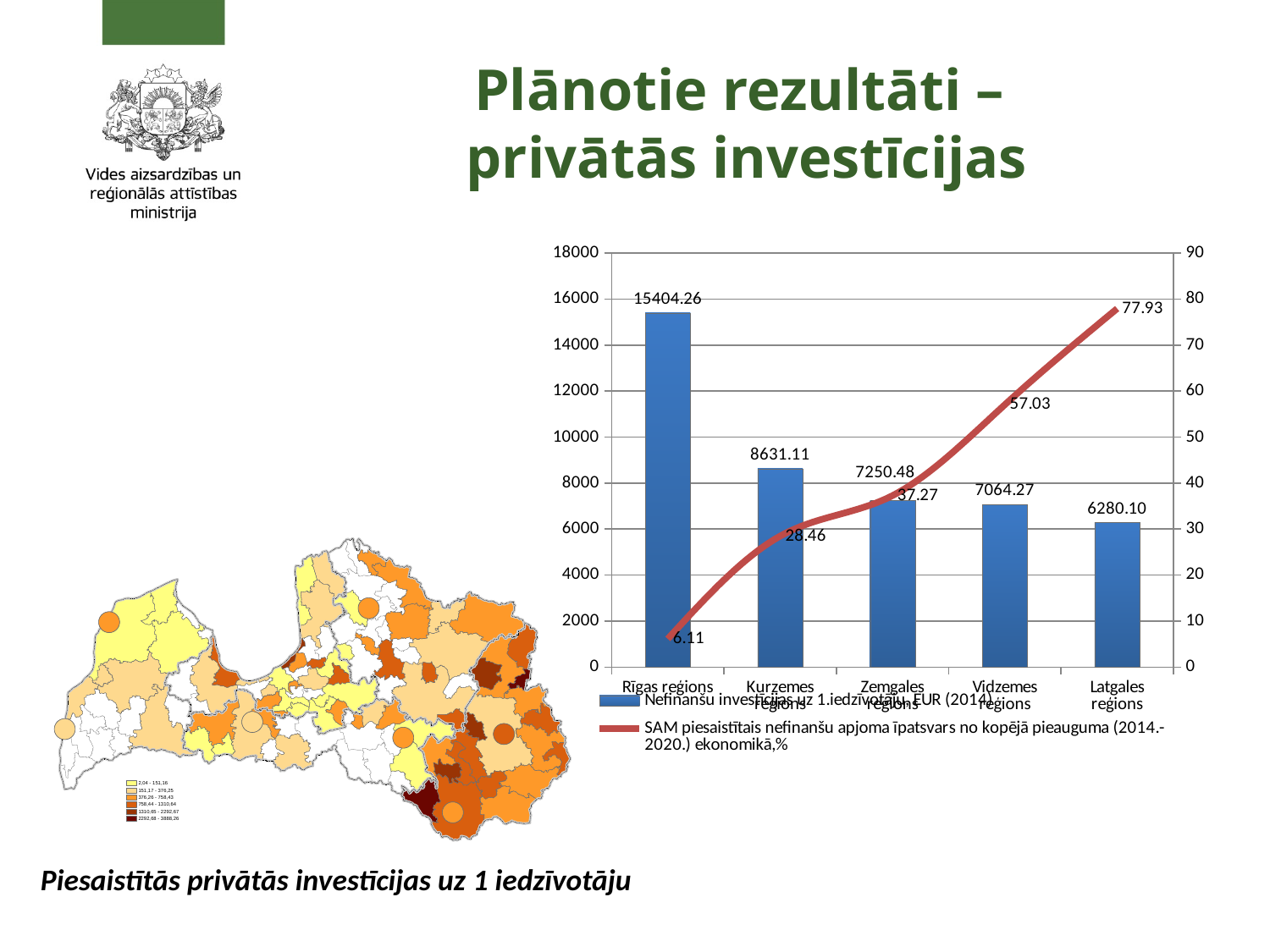
How many series does the chart legend list? 2 What is the difference between the bar values for Kurzemes reģions and Zemgales reģions? 1380.63 What is the value of the line series for Vidzemes reģions? 57.03 Is the bar value for Zemgales reģions greater or less than 8000? less What is the value of the bar for Rīgas reģions? 15404.26 Which region has the highest bar value? Rīgas reģions Which region has the lowest value on the line series? Rīgas reģions What is the value of the line series for Kurzemes reģions? 28.46 What is the value of the bar for Latgales reģions? 6280.10 How many regions are shown on the x axis of the chart? 5 Does the line series rise or fall from Rīgas reģions to Latgales reģions? rise Which has a larger bar value, Vidzemes reģions or Latgales reģions? Vidzemes reģions